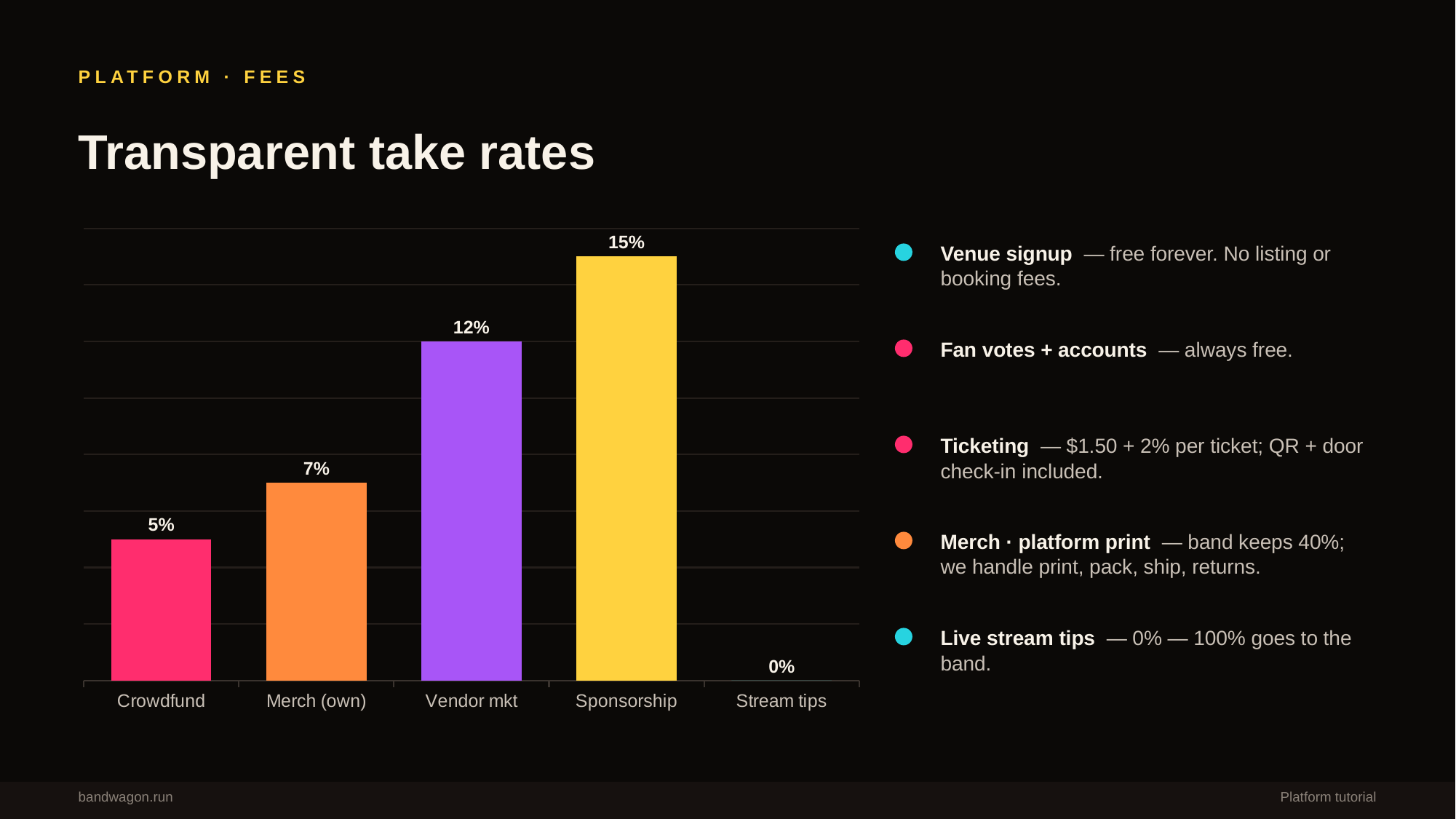
What is the take rate for Vendor mkt? 12% What is the difference between the take rates for Sponsorship and Merch (own)? 8% Which category has the highest take rate? Sponsorship Which category has the lowest take rate? Stream tips How many categories are shown on the chart? 5 Which has a higher take rate, Merch (own) or Vendor mkt? Vendor mkt What is the take rate for Crowdfund? 5% What colour is the Sponsorship bar? Yellow What is the take rate for Stream tips? 0% What kind of chart is shown on the slide? Bar chart What is the title of the slide containing the chart? Transparent take rates What is the difference between the take rates for Vendor mkt and Crowdfund? 7%